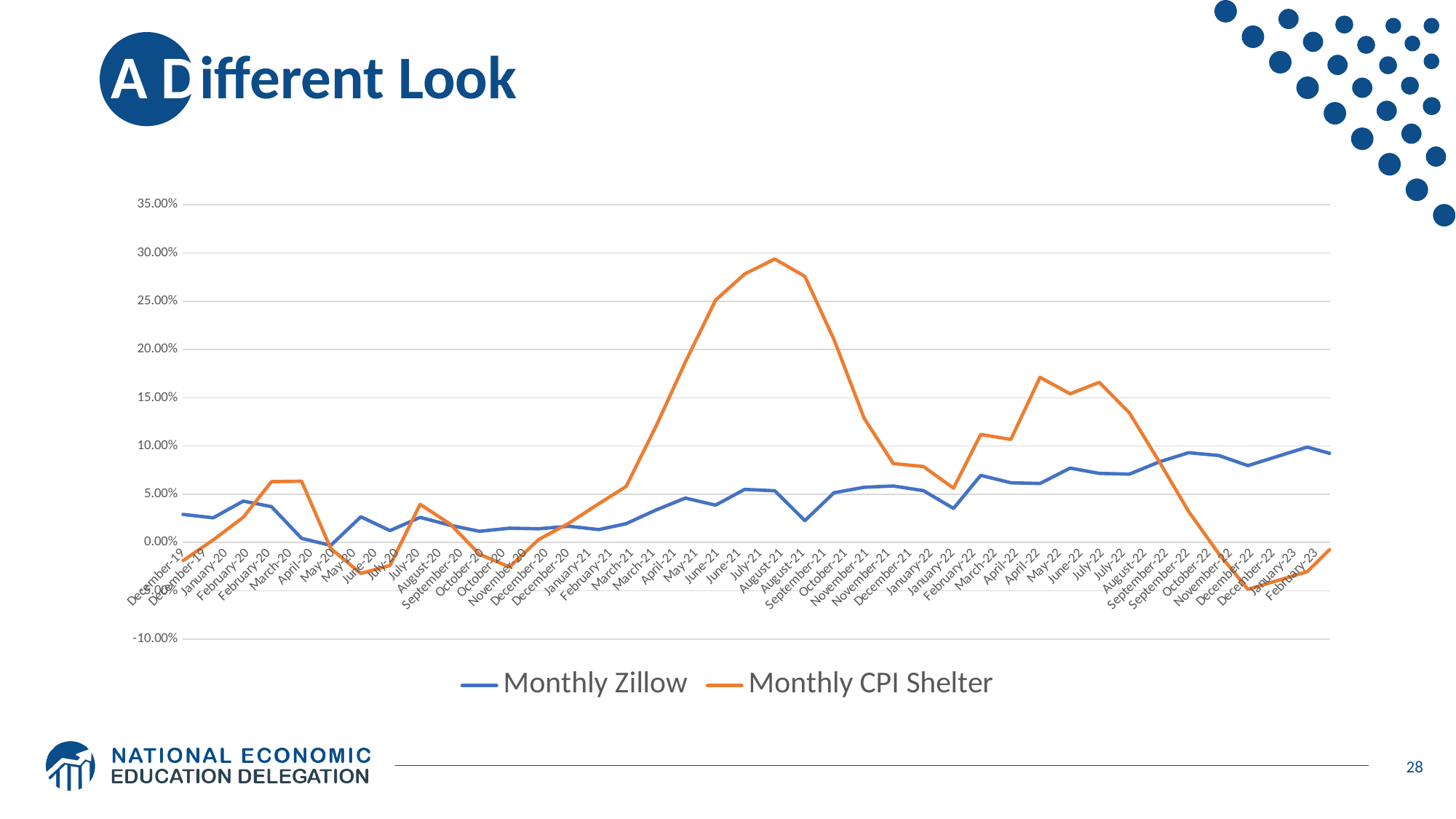
At August-21, which series has the higher value, Monthly Zillow or Monthly CPI Shelter? Monthly CPI Shelter What kind of chart is shown on the slide? line chart Is the Monthly Zillow value at August-21 greater or less than 10.00%? less Which series reaches the highest value anywhere on the chart? Monthly CPI Shelter Does the Monthly CPI Shelter line rise or fall between August-21 and November-21? fall Is the Monthly CPI Shelter value at December-22 greater or less than 0.00%? less Is the Monthly Zillow value at December-19 greater or less than 5.00%? less Which colour is used for the Monthly CPI Shelter line? orange How many series does the legend list? 2 What are the two series named in the legend? Monthly Zillow and Monthly CPI Shelter At December-22, which series has the higher value, Monthly Zillow or Monthly CPI Shelter? Monthly Zillow